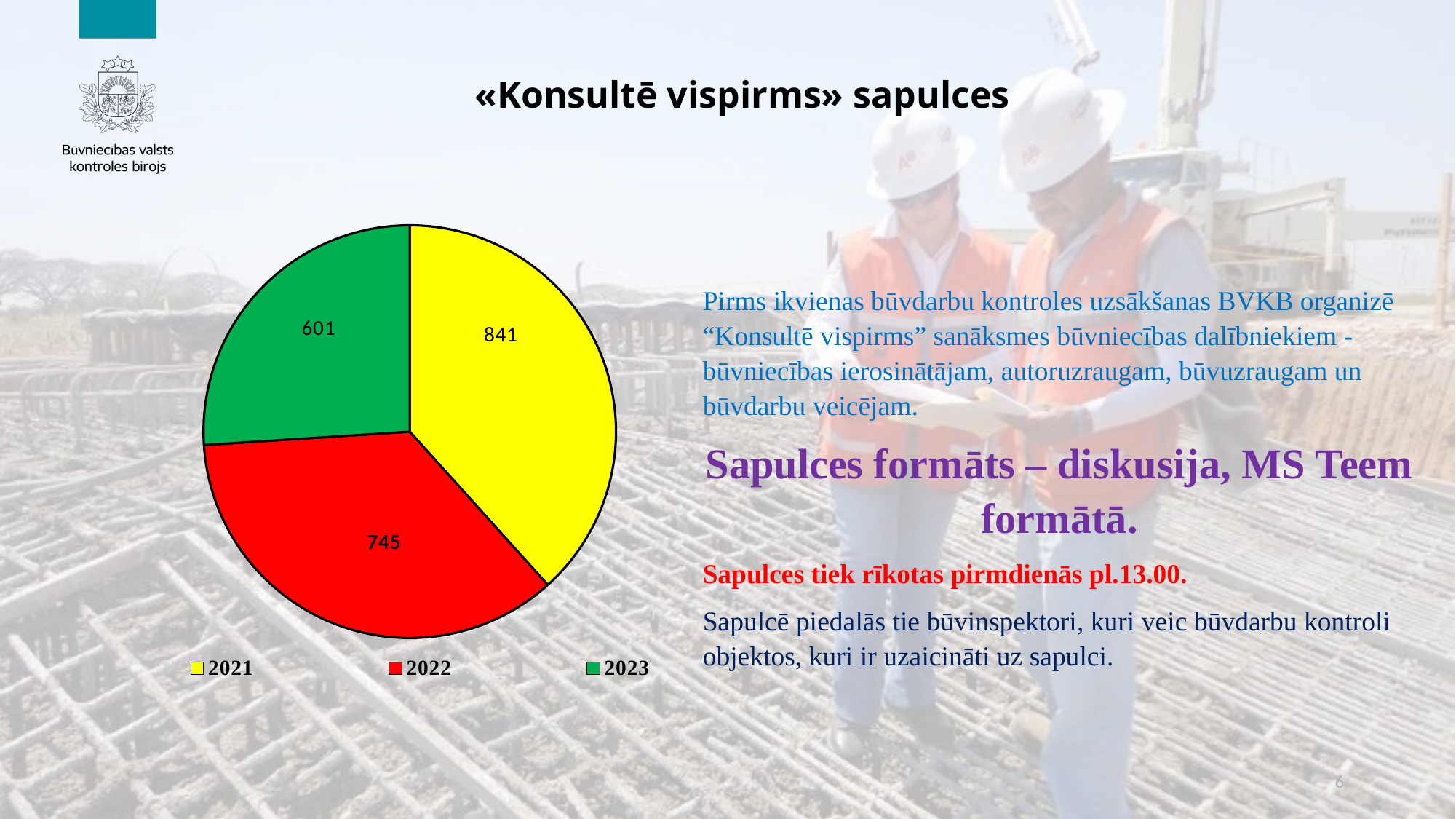
What is the value for 2022 in the pie chart? 745 What is the value for 2023 in the pie chart? 601 Which is larger, the value for 2022 or the value for 2023? 2022 How many slices does the pie chart have? 3 Which colour represents 2022 in the pie chart? Red What is the difference between the values for 2022 and 2023? 144 What is the total of all slices in the pie chart? 2187 What is the difference between the values for 2021 and 2023? 240 What kind of chart is shown on the slide? Pie chart What is the value for 2021 in the pie chart? 841 Which year has the largest slice in the pie chart? 2021 Which year has the smallest slice in the pie chart? 2023